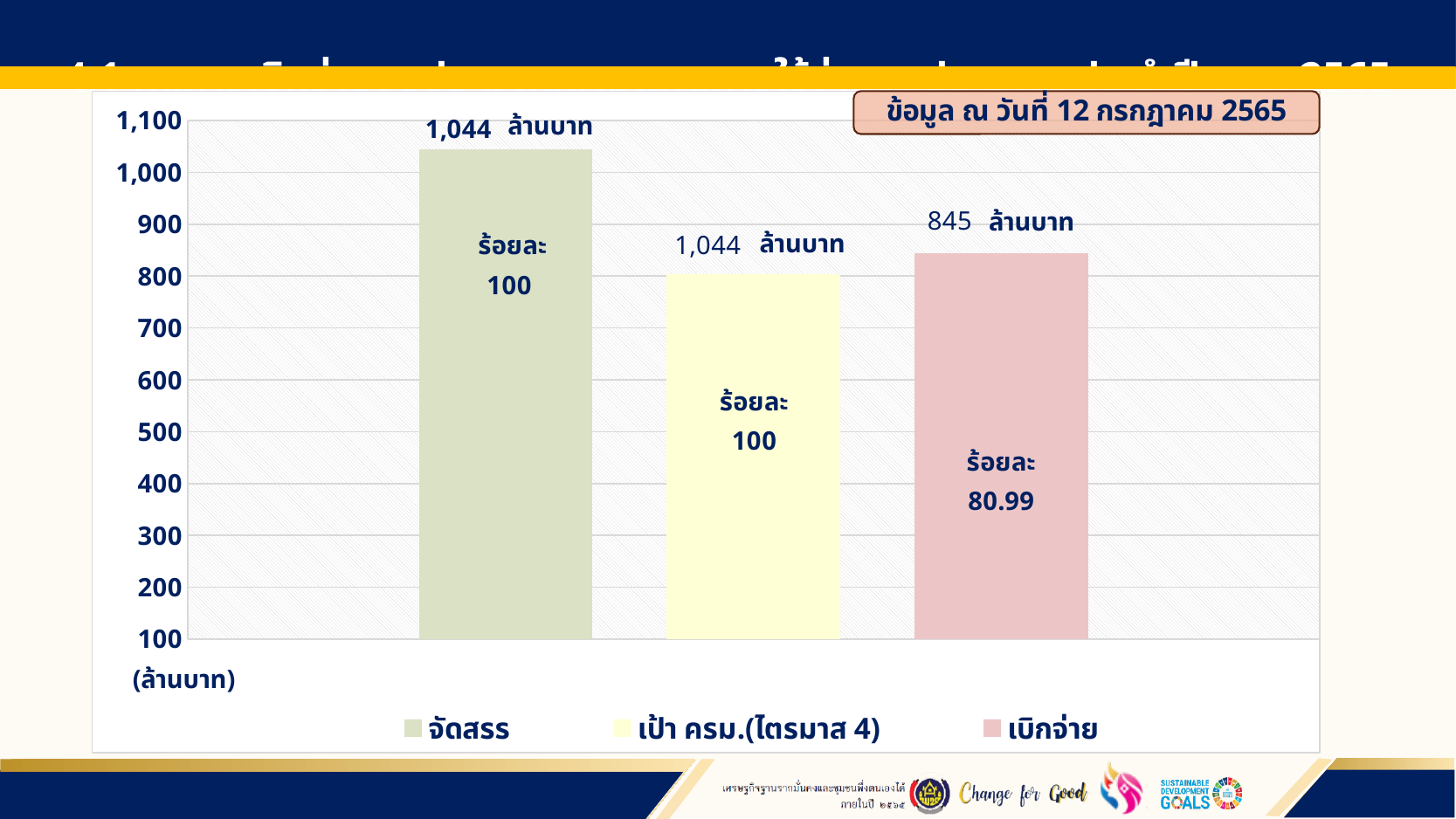
Is the value for เบิกจ่าย greater or less than 900? less How many bars are plotted in the chart? 3 What is the difference between the จัดสรร value and the เบิกจ่าย value? 199 ล้านบาท Is the value for จัดสรร greater or less than 1,000? greater How many entries does the legend list? 3 What percentage (ร้อยละ) is shown inside the เบิกจ่าย bar? 80.99 What value is labelled on the เบิกจ่าย bar? 845 ล้านบาท Which is larger, the value for จัดสรร or the value for เบิกจ่าย? จัดสรร What percentage (ร้อยละ) is shown inside the จัดสรร bar? 100 What type of chart is shown on the slide? bar chart What value is labelled on the จัดสรร bar? 1,044 ล้านบาท What value is labelled on the เป้า ครม.(ไตรมาส 4) bar? 1,044 ล้านบาท